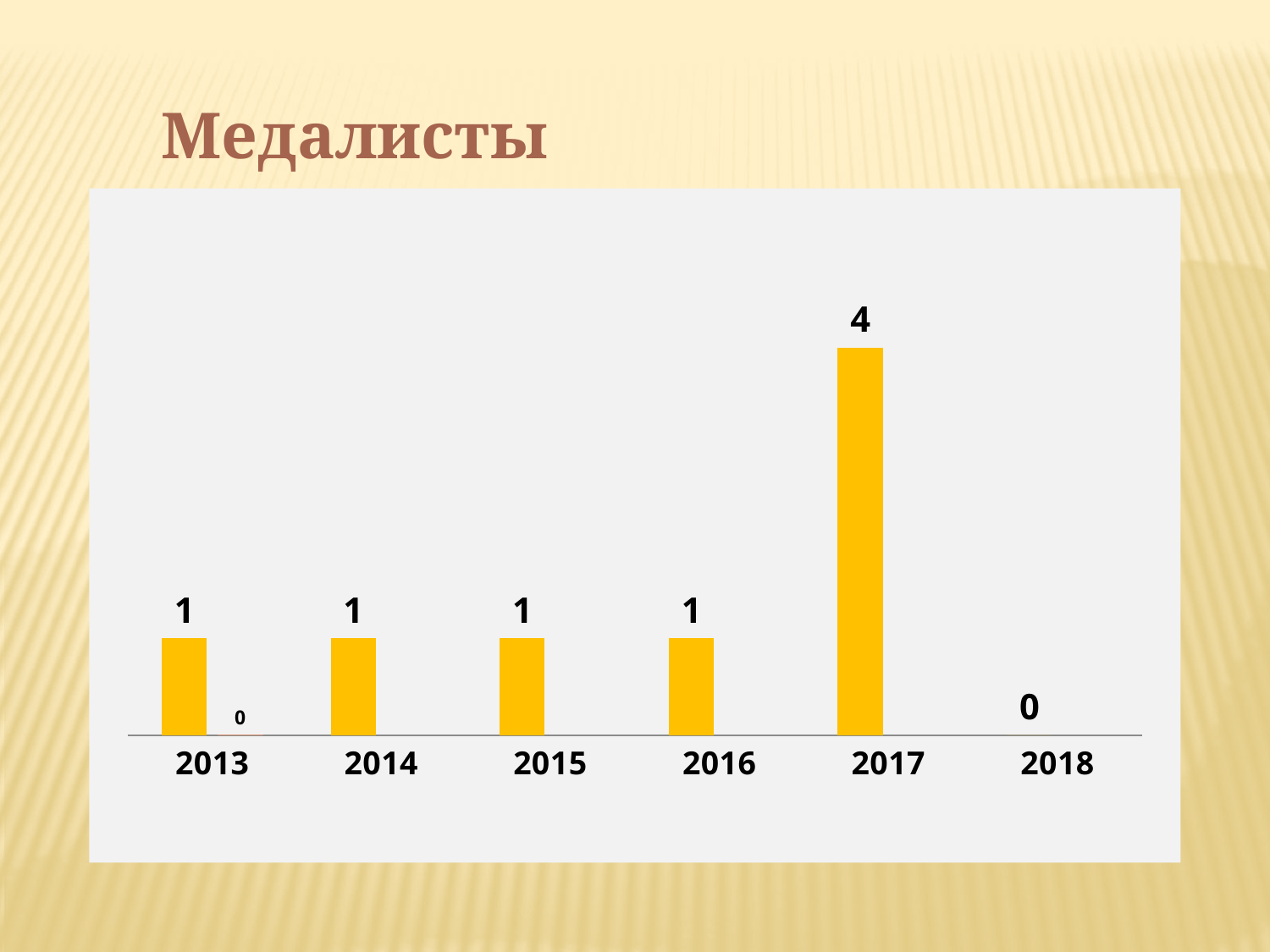
How many years are shown on the x axis? 6 Does the value fall or rise from 2017 to 2018? fall What kind of chart is shown on the slide? bar chart What colour are the bars in the chart? yellow What is the value for 2014? 1 What is the value for 2017? 4 Which is larger, the value for 2015 or the value for 2017? 2017 What is the difference between the values for 2017 and 2016? 3 Which year has the highest value? 2017 What is the value for 2018? 0 What is the title of the slide? Медалисты